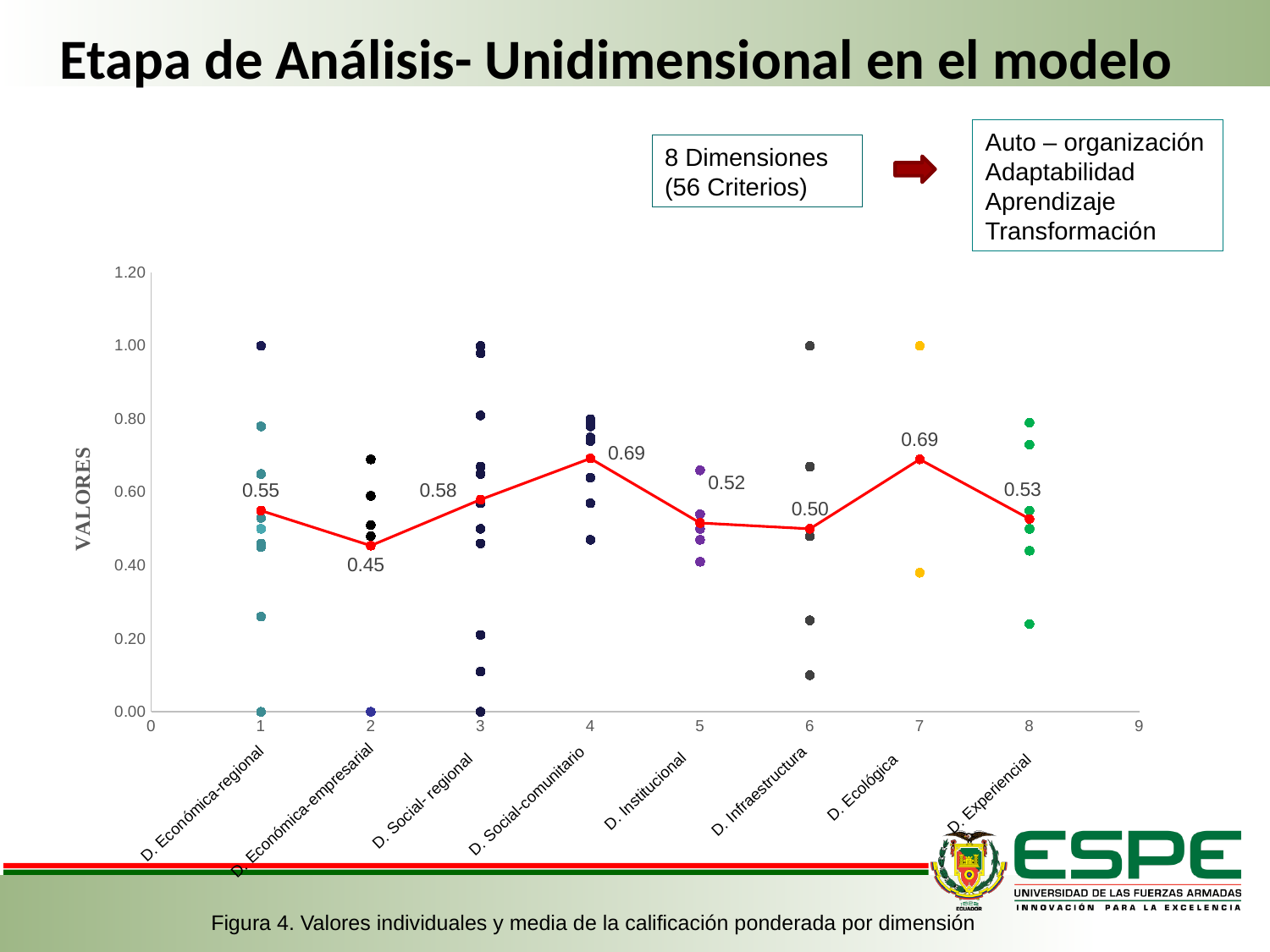
What is the mean value shown for D. Experiencial? 0.53 What is the mean value shown for D. Infraestructura? 0.50 What is the difference between the mean value for D. Ecológica and the mean value for D. Económica-empresarial? 0.24 Is the mean value for D. Infraestructura greater or less than 0.60? less What is the mean value shown for D. Económica-regional? 0.55 Which dimension has the lowest mean value on the red line? D. Económica-empresarial Does the red mean line rise or fall from D. Económica-regional to D. Económica-empresarial? fall What is the figure caption below the chart? Figura 4. Valores individuales y media de la calificación ponderada por dimensión What is the mean value shown for D. Social-comunitario? 0.69 Which has a higher mean value, D. Social- regional or D. Institucional? D. Social- regional How many dimensions are plotted along the x axis? 8 What is the label of the vertical axis? VALORES